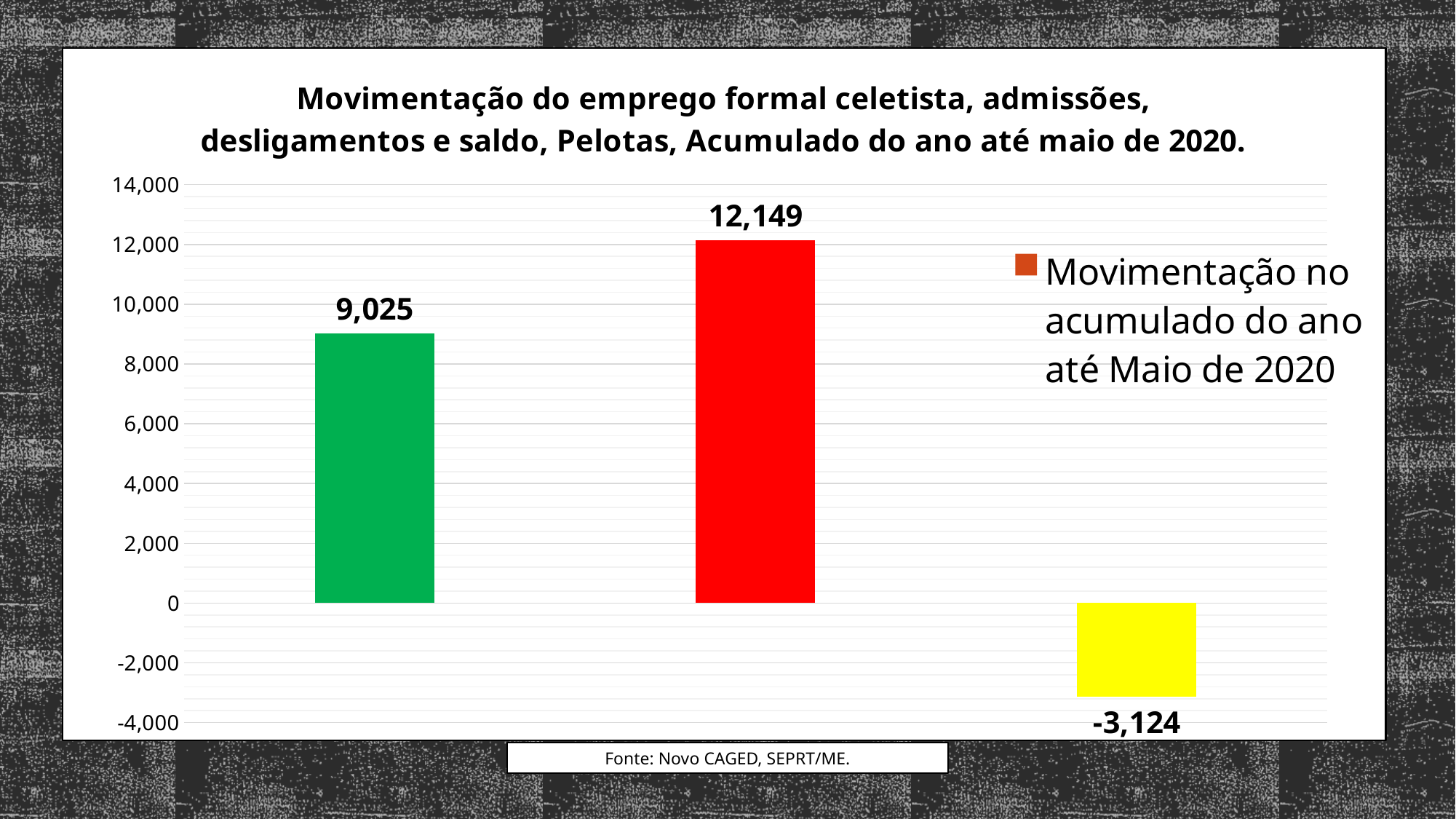
What is the difference between the red bar's value and the green bar's value? 3,124 What value is shown on the red bar? 12,149 What is the legend entry of the chart? Movimentação no acumulado do ano até Maio de 2020 How many bars are plotted in the chart? 3 What value is shown on the yellow bar? -3,124 Which bar has the lowest value? the yellow bar Is the value of the green bar greater or less than 10,000? less What value is shown on the green bar? 9,025 What kind of chart is shown on the slide? bar chart How many series does the legend list? 1 Which is larger, the value of the green bar or the value of the red bar? the red bar Which bar has the highest value? the red bar